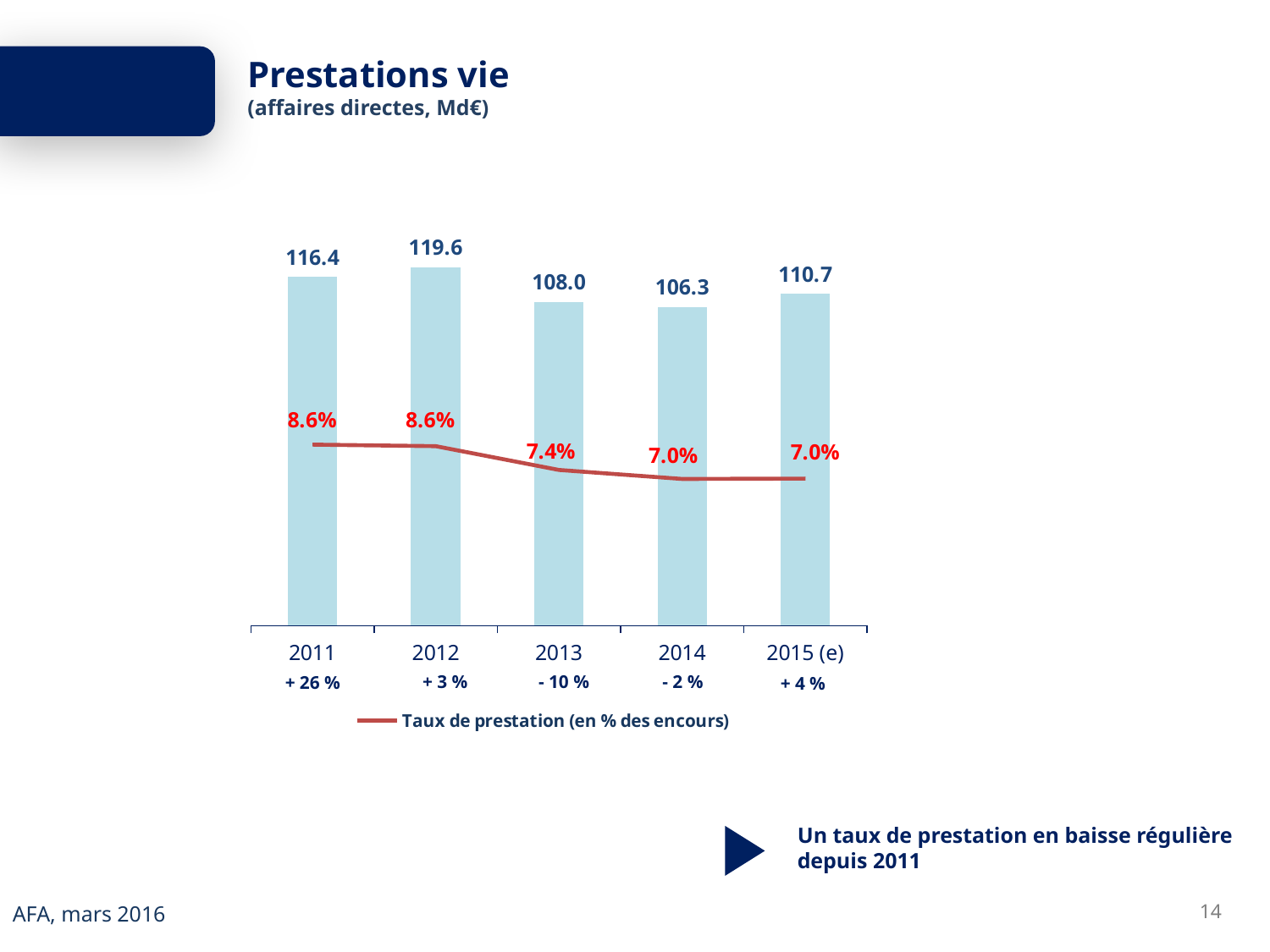
Does the 'Taux de prestation' line rise or fall from 2011 to 2015 (e)? Fall Which year has the lowest bar value? 2014 Which year has the highest bar value? 2012 What is the 'Taux de prestation' value shown for 2013? 7.4% What is the value of the bar for 2012? 119.6 How many years are shown on the x axis? 5 What is the difference between the bar values for 2012 and 2013? 11.6 How many series does the legend list? 1 Which is larger, the bar value for 2011 or for 2015 (e)? 2011 What kind of chart is shown on the slide? Combined bar and line chart What is the legend entry for the red line? Taux de prestation (en % des encours) What is the value of the bar for 2014? 106.3